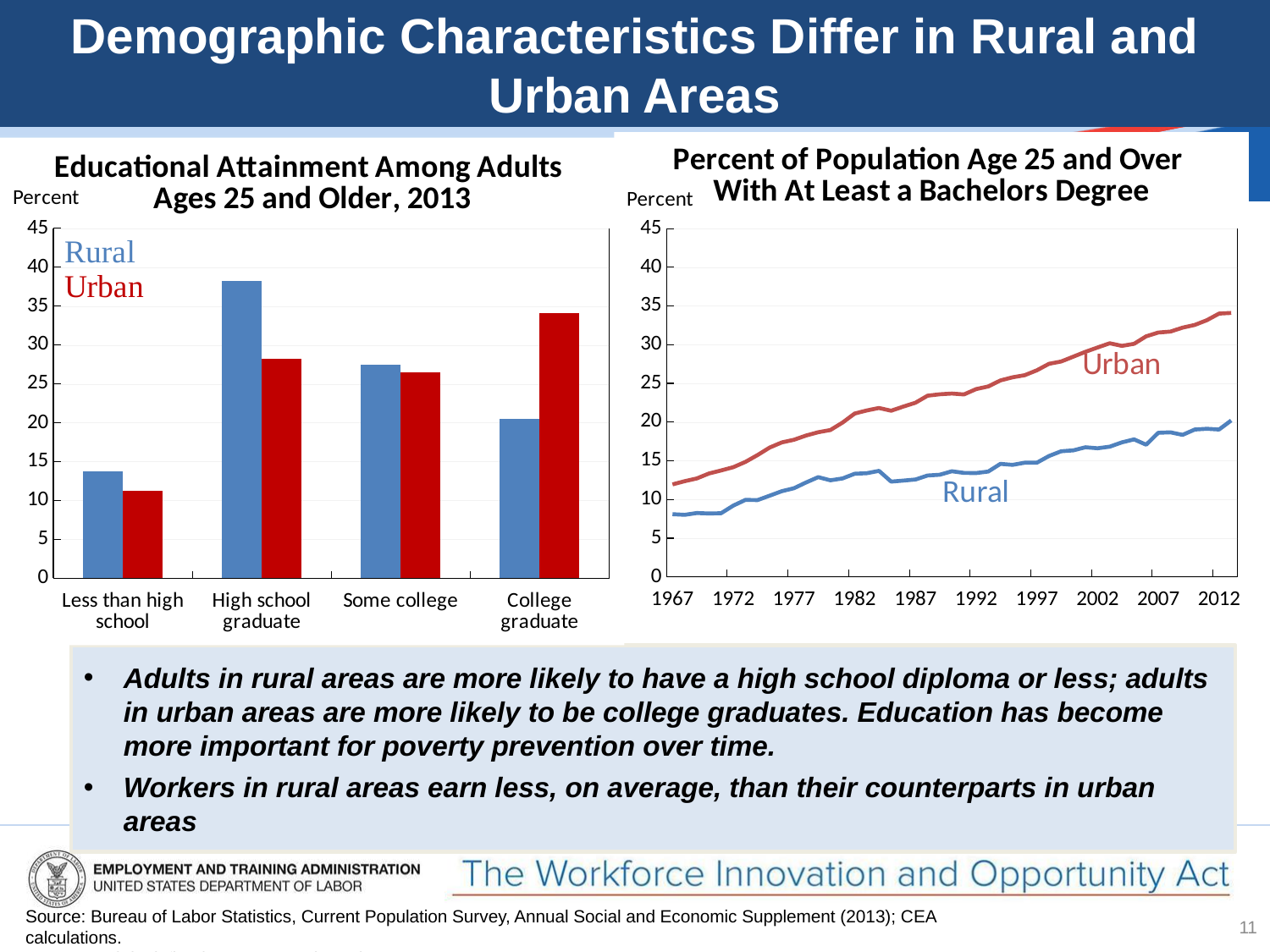
In the left chart, 'Educational Attainment Among Adults Ages 25 and Older, 2013', how many education categories are shown on the x axis? 4 In the left chart, 'Educational Attainment Among Adults Ages 25 and Older, 2013', is the Rural value for High school graduate greater or less than 35? greater In the left chart, 'Educational Attainment Among Adults Ages 25 and Older, 2013', how many series does the legend list? 2 In the left chart, 'Educational Attainment Among Adults Ages 25 and Older, 2013', which is larger for College graduate: Rural or Urban? Urban In the left chart, 'Educational Attainment Among Adults Ages 25 and Older, 2013', is the Urban value for Less than high school greater or less than 15? less What kind of chart is the right chart, 'Percent of Population Age 25 and Over With At Least a Bachelors Degree'? Line chart In the left chart, 'Educational Attainment Among Adults Ages 25 and Older, 2013', which education category has the highest Rural value? High school graduate What kind of chart is the left chart, 'Educational Attainment Among Adults Ages 25 and Older, 2013'? Bar chart In the left chart, 'Educational Attainment Among Adults Ages 25 and Older, 2013', which education category has the lowest Urban value? Less than high school In the right chart, 'Percent of Population Age 25 and Over With At Least a Bachelors Degree', do the Urban values rise or fall from 1967 to 2012? Rise In the right chart, 'Percent of Population Age 25 and Over With At Least a Bachelors Degree', which line is higher in 2012: Urban or Rural? Urban In the right chart, 'Percent of Population Age 25 and Over With At Least a Bachelors Degree', is the Rural value in 2012 greater or less than 25? less